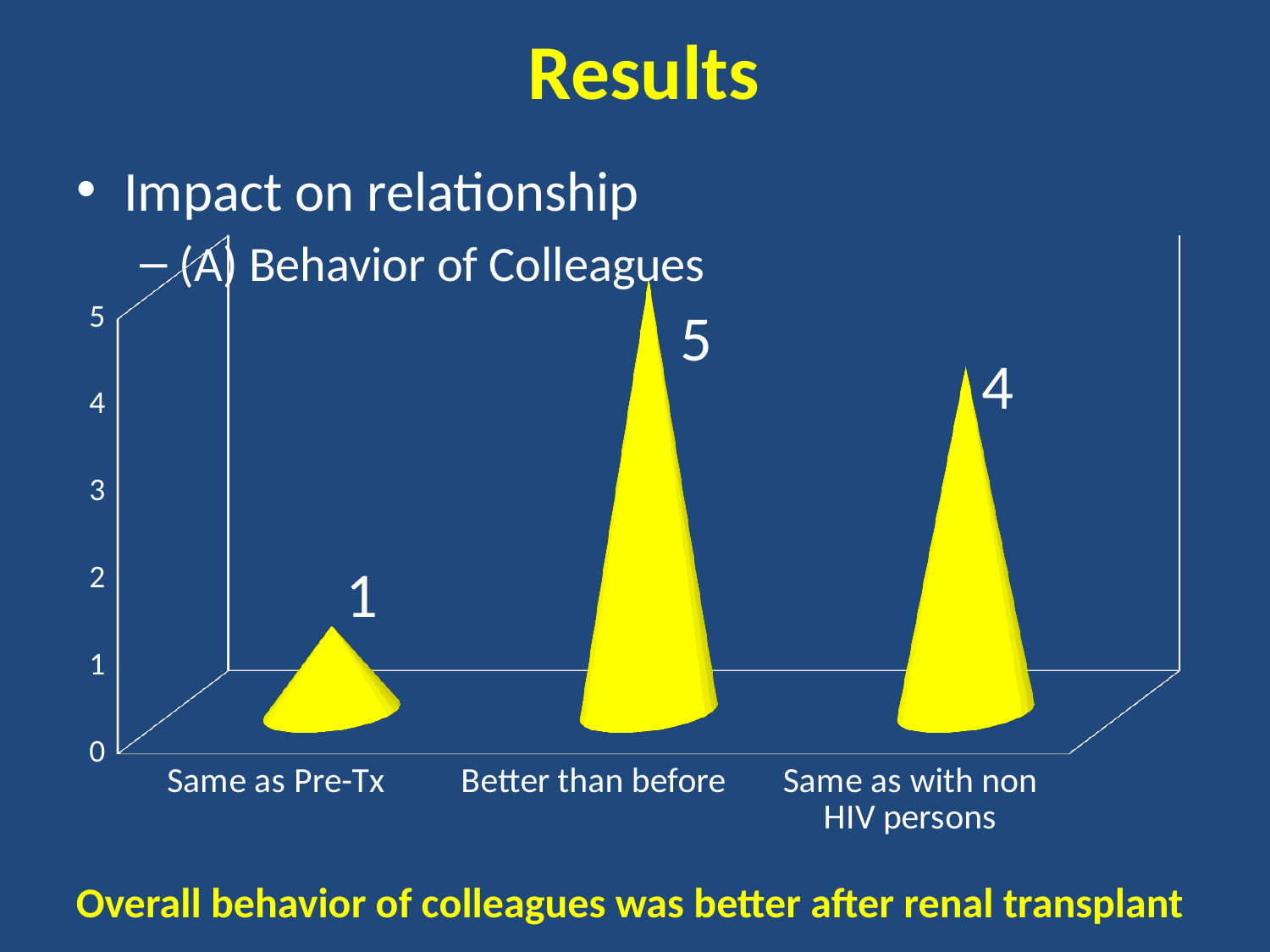
What is the value for "Same as with non HIV persons"? 4 What is the difference between the values for "Better than before" and "Same as Pre-Tx"? 4 What is the value for "Same as Pre-Tx"? 1 How many categories are shown on the chart? 3 What colour are the bars on the chart? Yellow Which is larger, the value for "Same as with non HIV persons" or the value for "Same as Pre-Tx"? Same as with non HIV persons What is the difference between the values for "Better than before" and "Same as with non HIV persons"? 1 Which category has the lowest value? Same as Pre-Tx Which category has the highest value? Better than before What kind of chart is shown on the slide? Bar chart What is the value for "Better than before"? 5 What is the total of the three values shown on the chart? 10